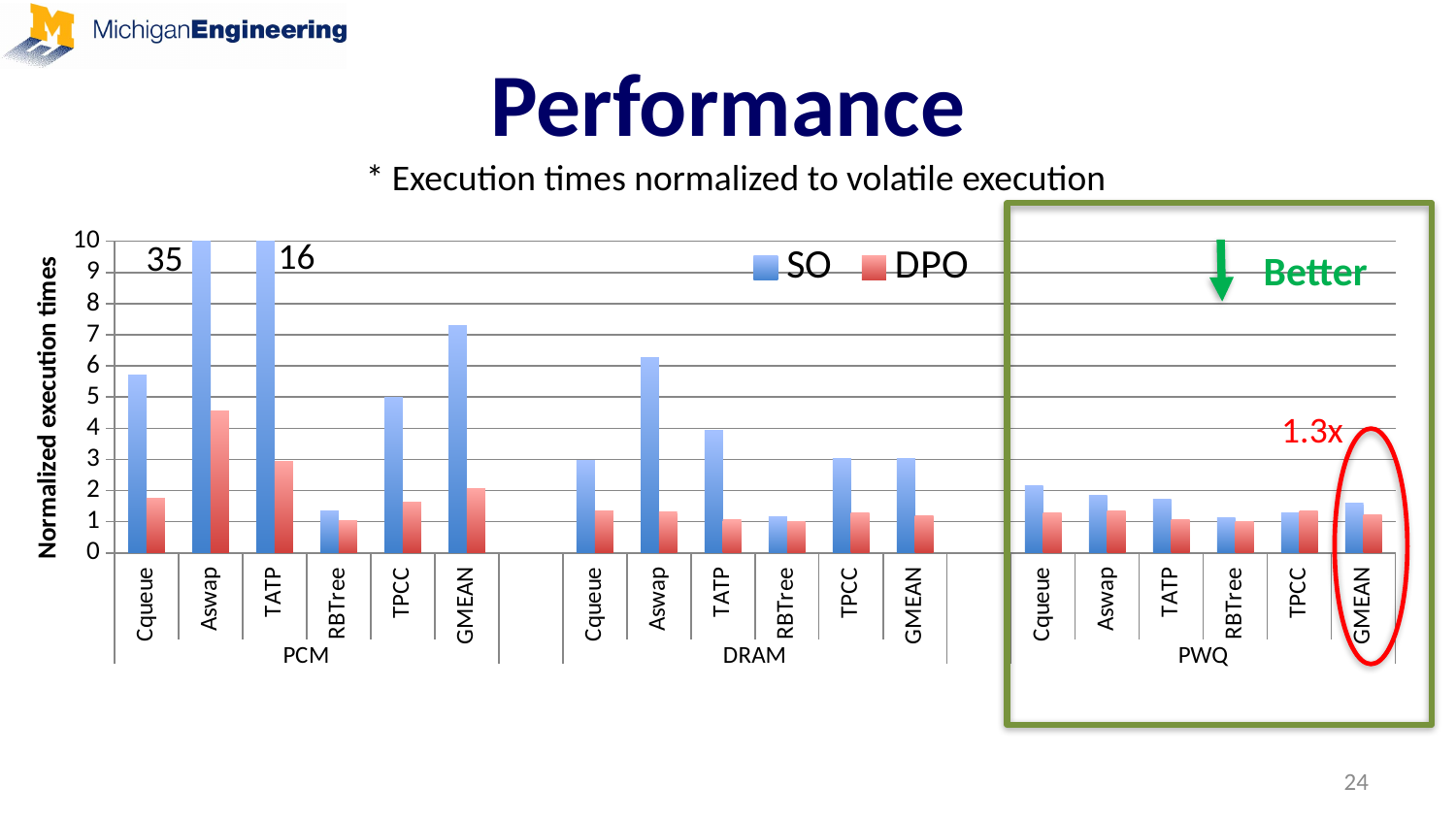
What are the two series named in the legend? SO and DPO For TATP in the PCM group, which is larger, the SO value or the DPO value? SO Which category in the PCM group has the highest SO value? Aswap What value is labeled for the SO bar of TATP in the PCM group? 16 Is the SO value for Cqueue in the PCM group greater or less than 4? greater What kind of chart is shown on the slide? bar chart How many series does the legend list? 2 What value is labeled for the SO bar of Aswap in the PCM group? 35 Is the SO value for Aswap in the DRAM group greater or less than 5? greater How many benchmark categories are plotted across all three groups (PCM, DRAM, PWQ)? 18 Which group of bars is enclosed by the green box? PWQ Is the DPO value for Aswap in the PCM group greater or less than 4? greater